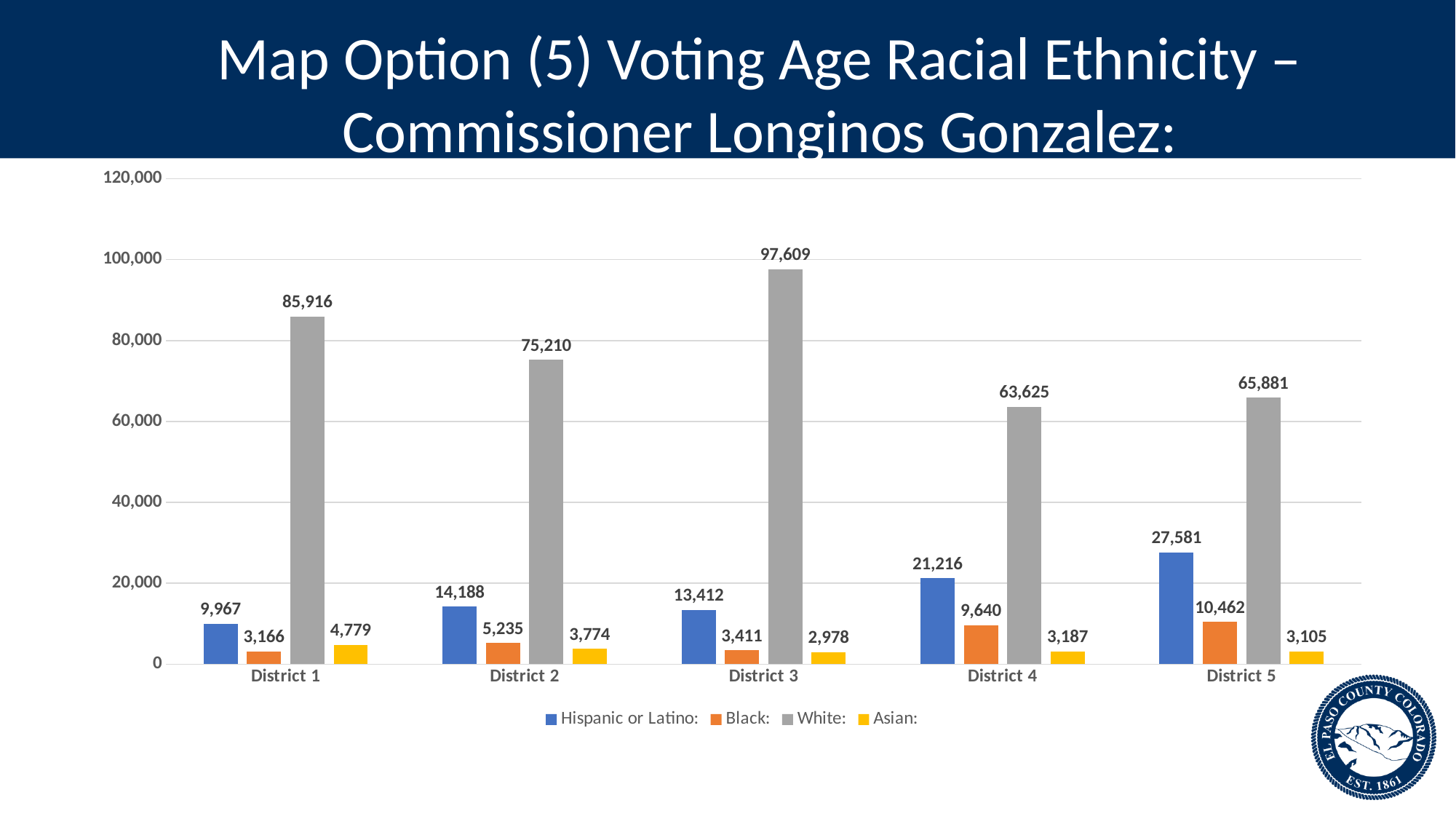
What is the Asian value for District 1? 4,779 How many districts are shown on the x axis? 5 Which district has the lowest Hispanic or Latino value? District 1 What is the White value for District 3? 97,609 Which is larger, the Black value for District 4 or the Black value for District 5? District 5 What is the Hispanic or Latino value for District 5? 27,581 Which district has the highest White value? District 3 Is the Hispanic or Latino value for District 4 greater or less than 20,000? greater What kind of chart is shown on the slide? bar chart What is the Black value for District 2? 5,235 What is the difference between the White values for District 1 and District 2? 10,706 How many series does the legend list? 4